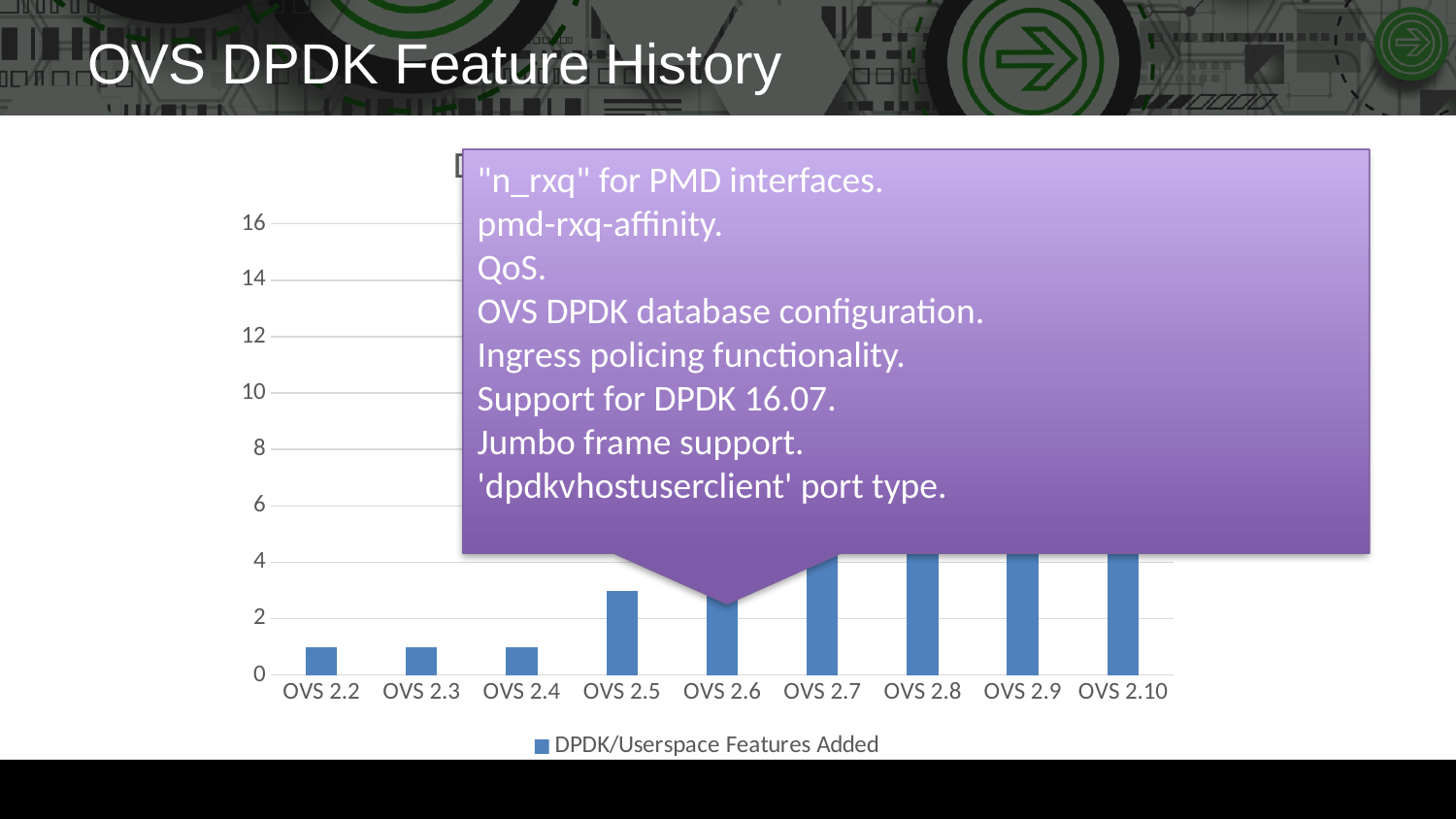
How many OVS versions are shown along the x axis of the chart? 9 Is the value for OVS 2.8 greater or less than 4? greater Do the values generally rise or fall from OVS 2.2 to OVS 2.10 along the x axis? rise Is the value for OVS 2.2 greater or less than 2? less Which has the larger value, OVS 2.5 or OVS 2.3? OVS 2.5 What is the series name shown in the chart's legend? DPDK/Userspace Features Added Which has the larger value, OVS 2.4 or OVS 2.9? OVS 2.9 How many series does the chart's legend list? 1 Is the value for OVS 2.5 greater or less than 2? greater What kind of chart is shown on the slide? bar chart